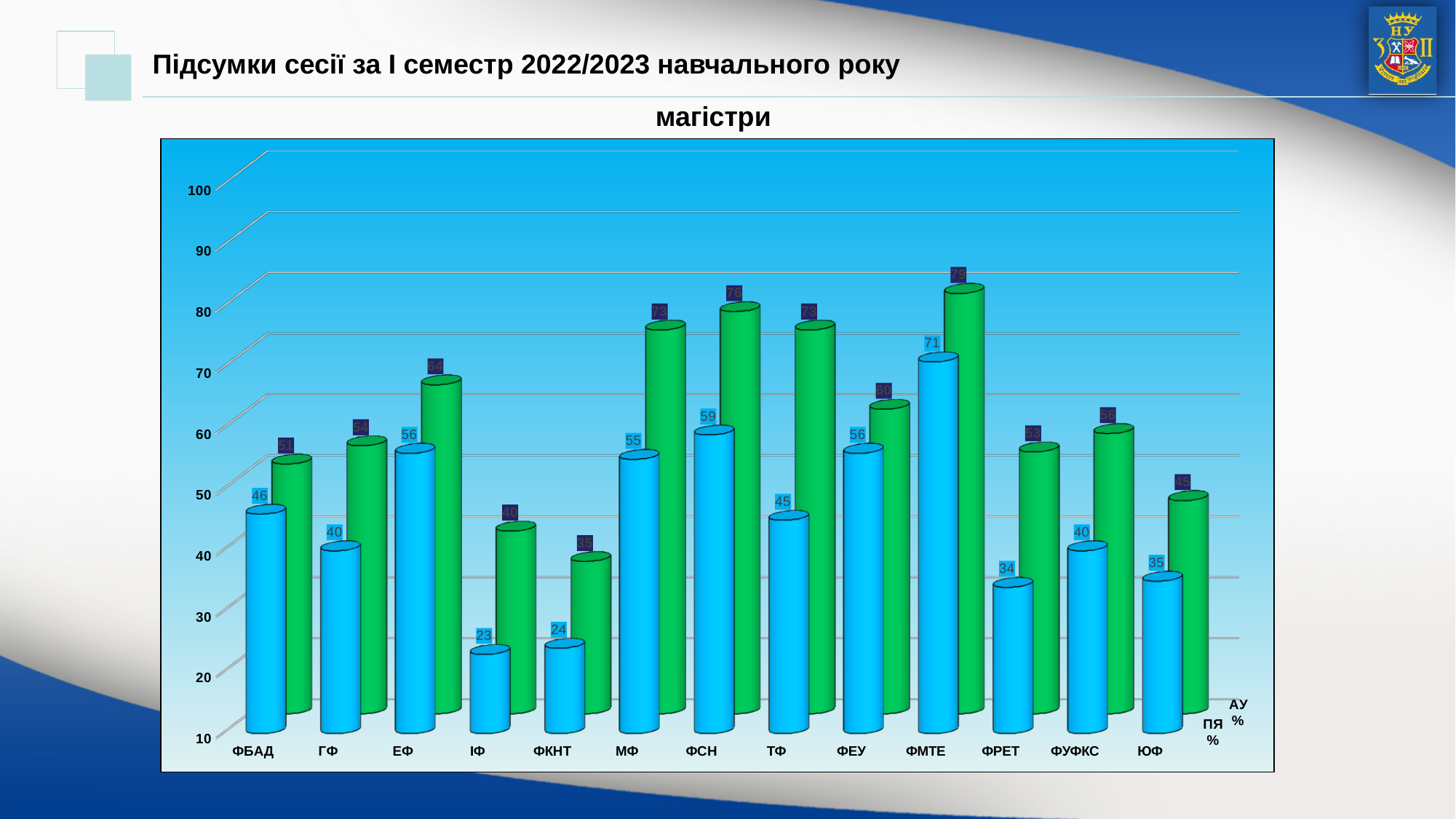
What is the АУ % value for ЮФ? 45 What is the ПЯ % value for ФМТЕ? 71 Which faculty has the lowest ПЯ % value? ІФ How many faculties (categories) are shown on the x axis of the chart? 13 What is the title of the chart? магістри What is the АУ % value for ФСН? 76 What type of chart is shown on the slide? bar chart Which faculty has the highest АУ % value? ФМТЕ Which is larger, the ПЯ % value for ФСН or the ПЯ % value for ТФ? ФСН What is the difference between the АУ % and ПЯ % values for МФ? 18 What is the ПЯ % value for ІФ? 23 Is the АУ % value for ФКНТ greater or less than 40? less